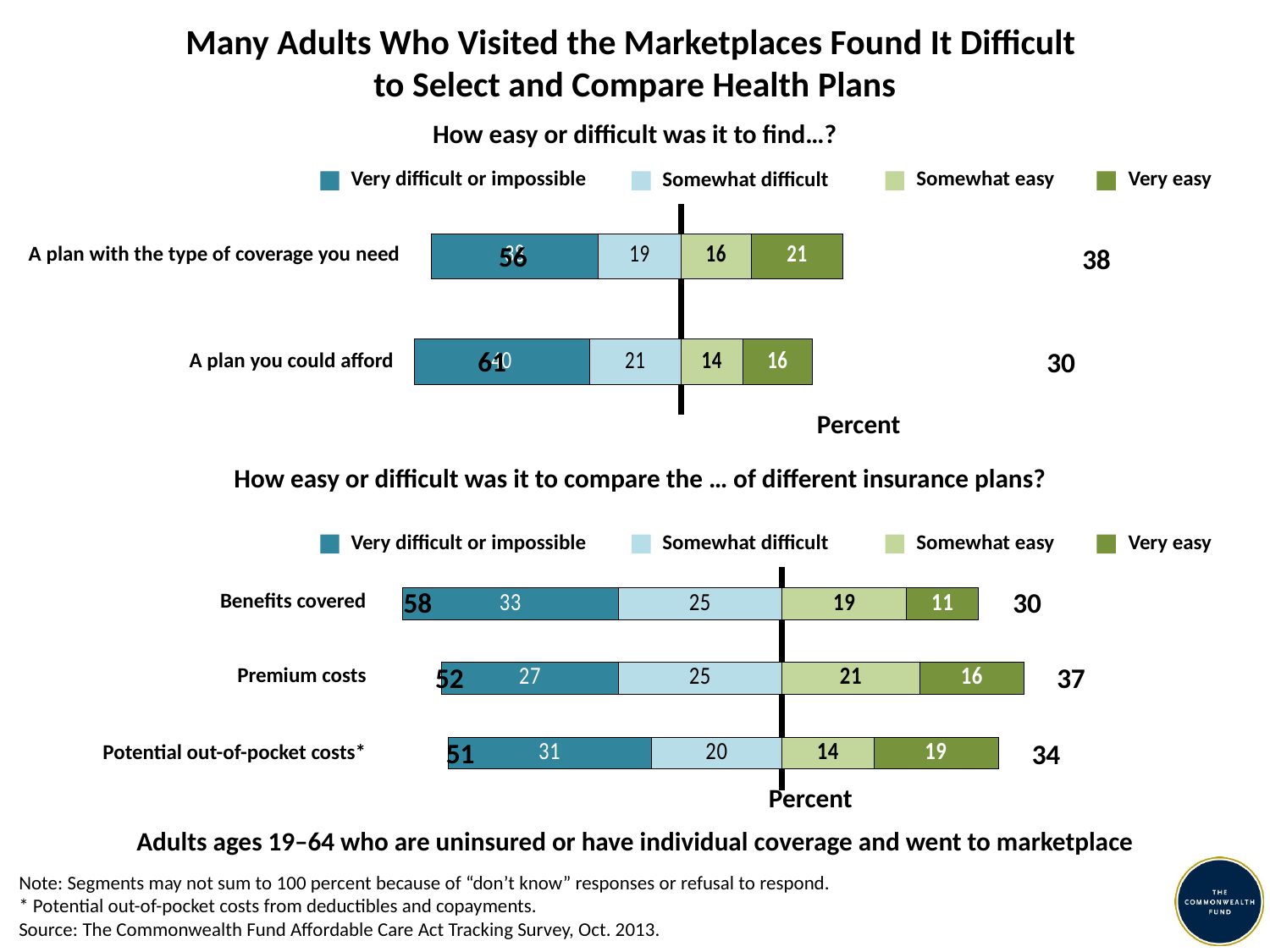
In the top chart ("How easy or difficult was it to find...?"), how many series does the legend list? 4 In the bottom chart ("How easy or difficult was it to compare the ... of different insurance plans?"), which category has the highest Very easy value? Potential out-of-pocket costs* In the top chart ("How easy or difficult was it to find...?"), what is the Somewhat difficult value for "A plan you could afford"? 21 In the bottom chart ("How easy or difficult was it to compare the ... of different insurance plans?"), what is the difference between the Very difficult or impossible values for Benefits covered and Premium costs? 6 In the bottom chart ("How easy or difficult was it to compare the ... of different insurance plans?"), what is the Very easy value for Potential out-of-pocket costs*? 19 In the top chart ("How easy or difficult was it to find...?"), which category has the larger Somewhat easy value, "A plan with the type of coverage you need" or "A plan you could afford"? A plan with the type of coverage you need In the top chart ("How easy or difficult was it to find...?"), how many categories are shown? 2 In the top chart ("How easy or difficult was it to find...?"), what is the Very easy value for "A plan with the type of coverage you need"? 21 In the bottom chart ("How easy or difficult was it to compare the ... of different insurance plans?"), how many categories are shown? 3 In the bottom chart ("How easy or difficult was it to compare the ... of different insurance plans?"), which category has the lowest Somewhat easy value? Potential out-of-pocket costs* In the bottom chart ("How easy or difficult was it to compare the ... of different insurance plans?"), what is the Very difficult or impossible value for Benefits covered? 33 What type of chart is the bottom chart ("How easy or difficult was it to compare the ... of different insurance plans?")? Stacked bar chart